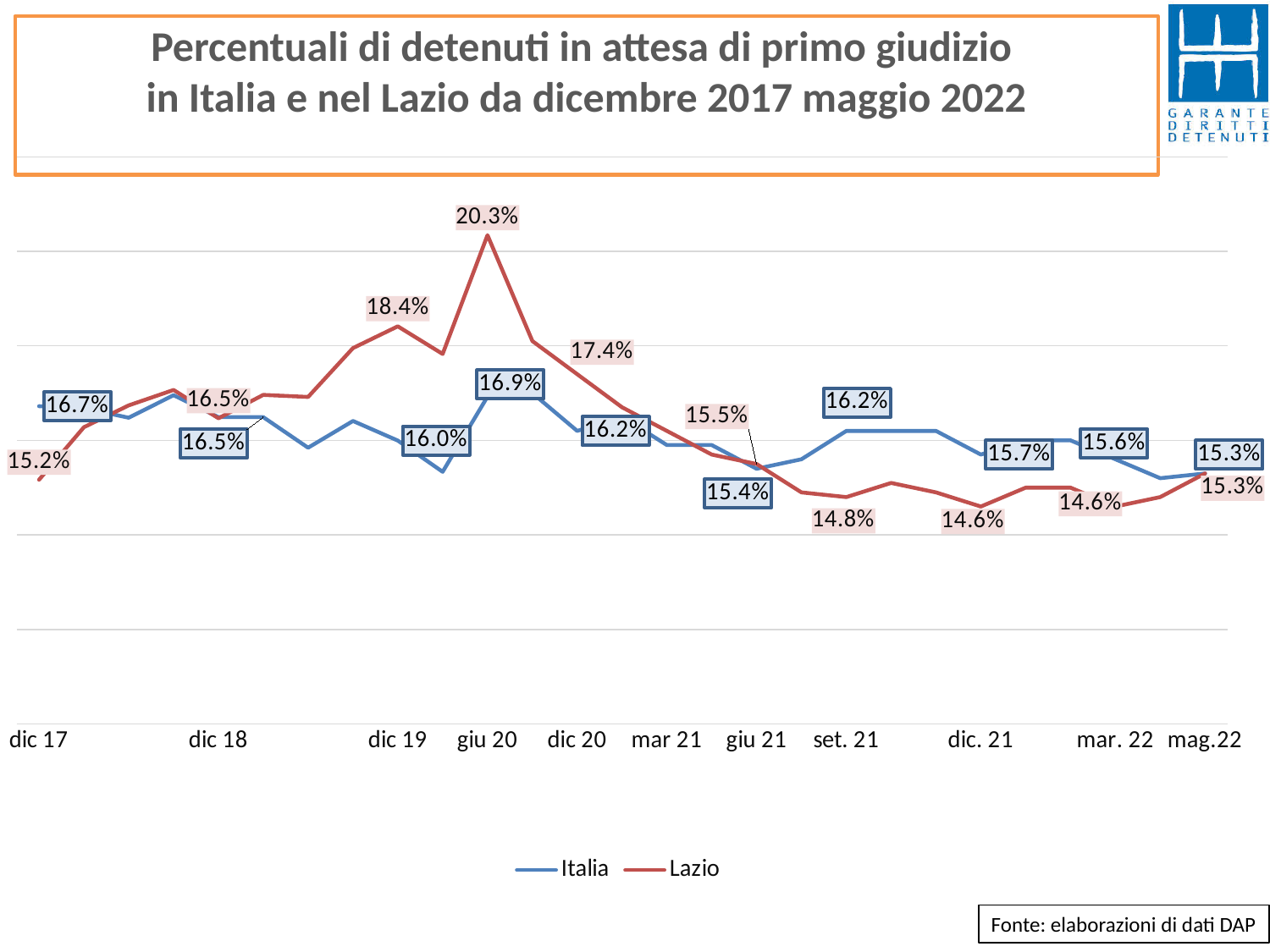
What is the value for both Italia and Lazio at mag.22? 15.3% What is the value for Lazio at dic 17? 15.2% What is the difference between the Lazio and Italia values at giu 20? 3.4 percentage points How many series does the legend list? 2 What kind of chart is shown on the slide? line chart What is the value for Italia at giu 20? 16.9% At dic 19, which series has the higher value, Italia or Lazio? Lazio What is the value for Lazio at giu 20? 20.3% What is the value for Lazio at dic 19? 18.4% At which point on the x axis does Lazio reach its highest value? giu 20 What is the value for Italia at dic 17? 16.7% Which two series are shown in the legend? Italia and Lazio